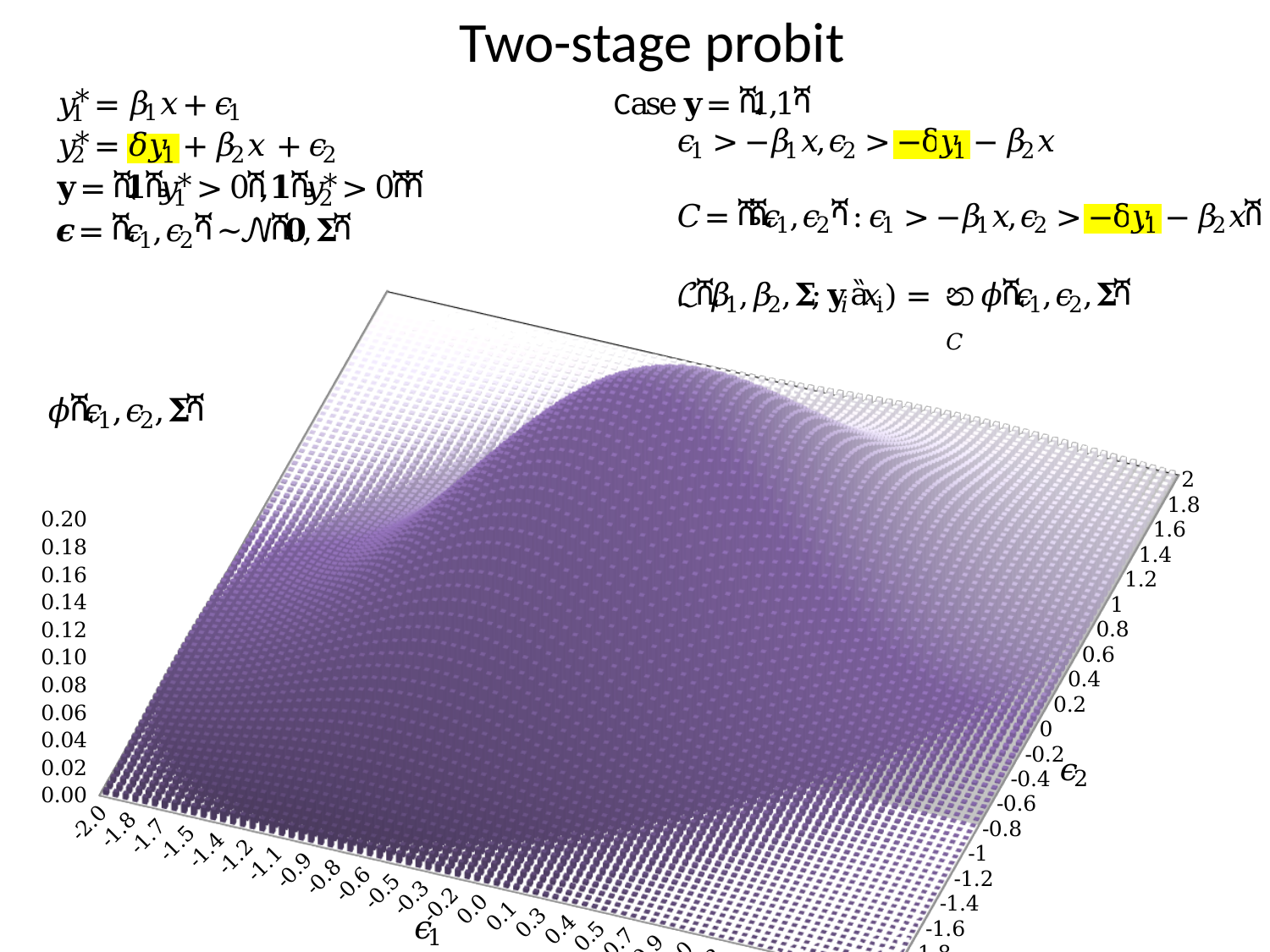
What is the highest tick value shown on the vertical axis of the chart? 0.20 What kind of chart is shown on the slide? 3D surface chart Is the peak value of the plotted surface greater or less than 0.10? greater What is the label on the axis running along the bottom-left edge of the chart? ε1